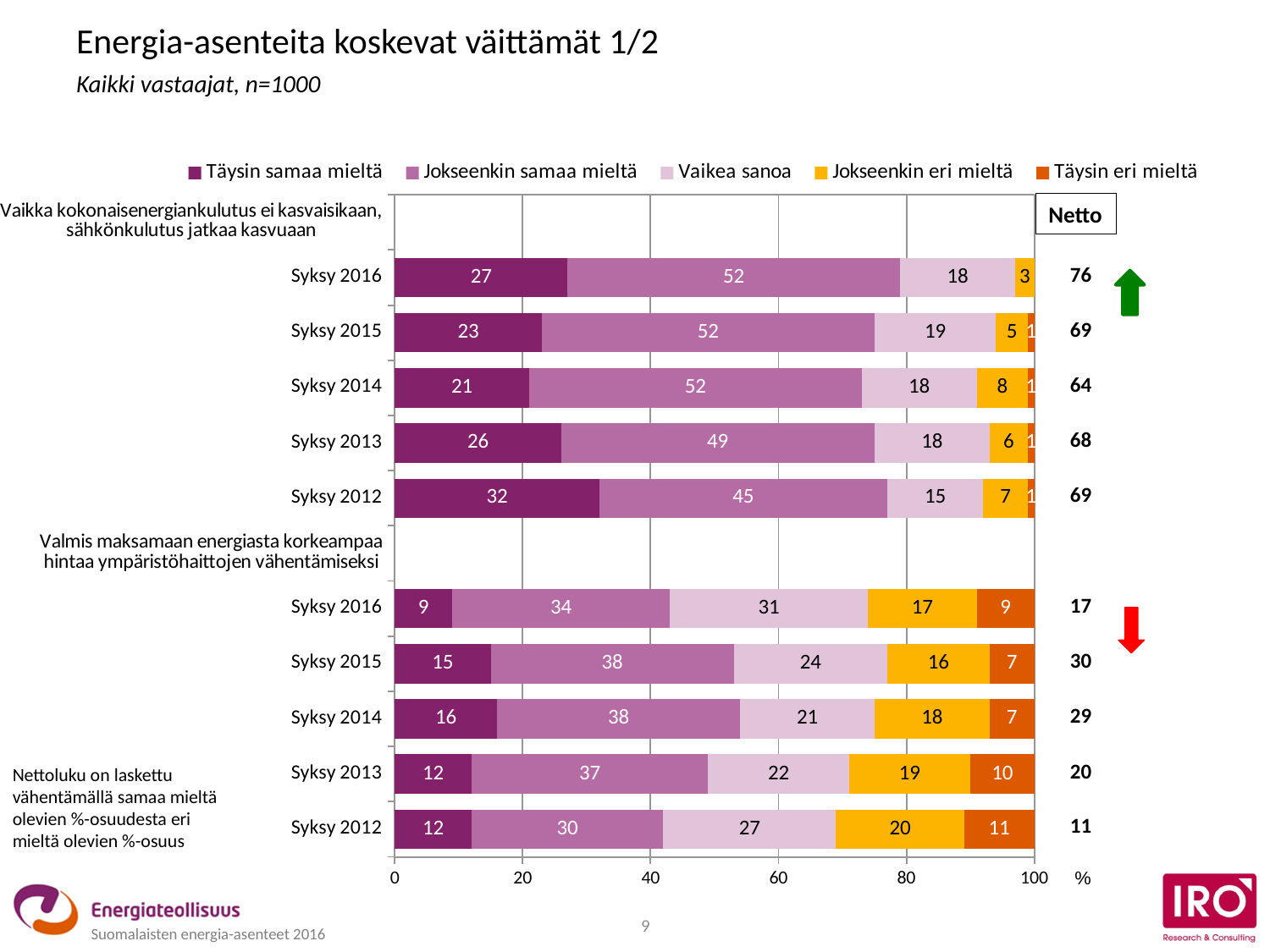
In the statement 'Vaikka kokonaisenergiankulutus ei kasvaisikaan, sähkönkulutus jatkaa kasvuaan', what is the 'Täysin samaa mieltä' value for Syksy 2016? 27 For the statement 'Vaikka kokonaisenergiankulutus ei kasvaisikaan, sähkönkulutus jatkaa kasvuaan', which year has the larger 'Täysin samaa mieltä' value, Syksy 2012 or Syksy 2016? Syksy 2012 What is the first entry in the chart legend? Täysin samaa mieltä For the statement 'Valmis maksamaan energiasta korkeampaa hintaa ympäristöhaittojen vähentämiseksi', what is the difference between the Netto values of Syksy 2016 and Syksy 2012? 6 What kind of chart is shown on the slide? Stacked bar chart For the statement 'Valmis maksamaan energiasta korkeampaa hintaa ympäristöhaittojen vähentämiseksi', which year has the lowest Netto value? Syksy 2012 In the statement 'Valmis maksamaan energiasta korkeampaa hintaa ympäristöhaittojen vähentämiseksi', what is the 'Täysin eri mieltä' value for Syksy 2012? 11 How many series does the chart legend list? 5 For the statement 'Vaikka kokonaisenergiankulutus ei kasvaisikaan, sähkönkulutus jatkaa kasvuaan', which year has the highest Netto value? Syksy 2016 How many bars are plotted in the chart in total? 10 For the statement 'Vaikka kokonaisenergiankulutus ei kasvaisikaan, sähkönkulutus jatkaa kasvuaan', what is the difference between the 'Jokseenkin eri mieltä' values of Syksy 2014 and Syksy 2016? 5 In the statement 'Valmis maksamaan energiasta korkeampaa hintaa ympäristöhaittojen vähentämiseksi', what is the 'Vaikea sanoa' value for Syksy 2016? 31